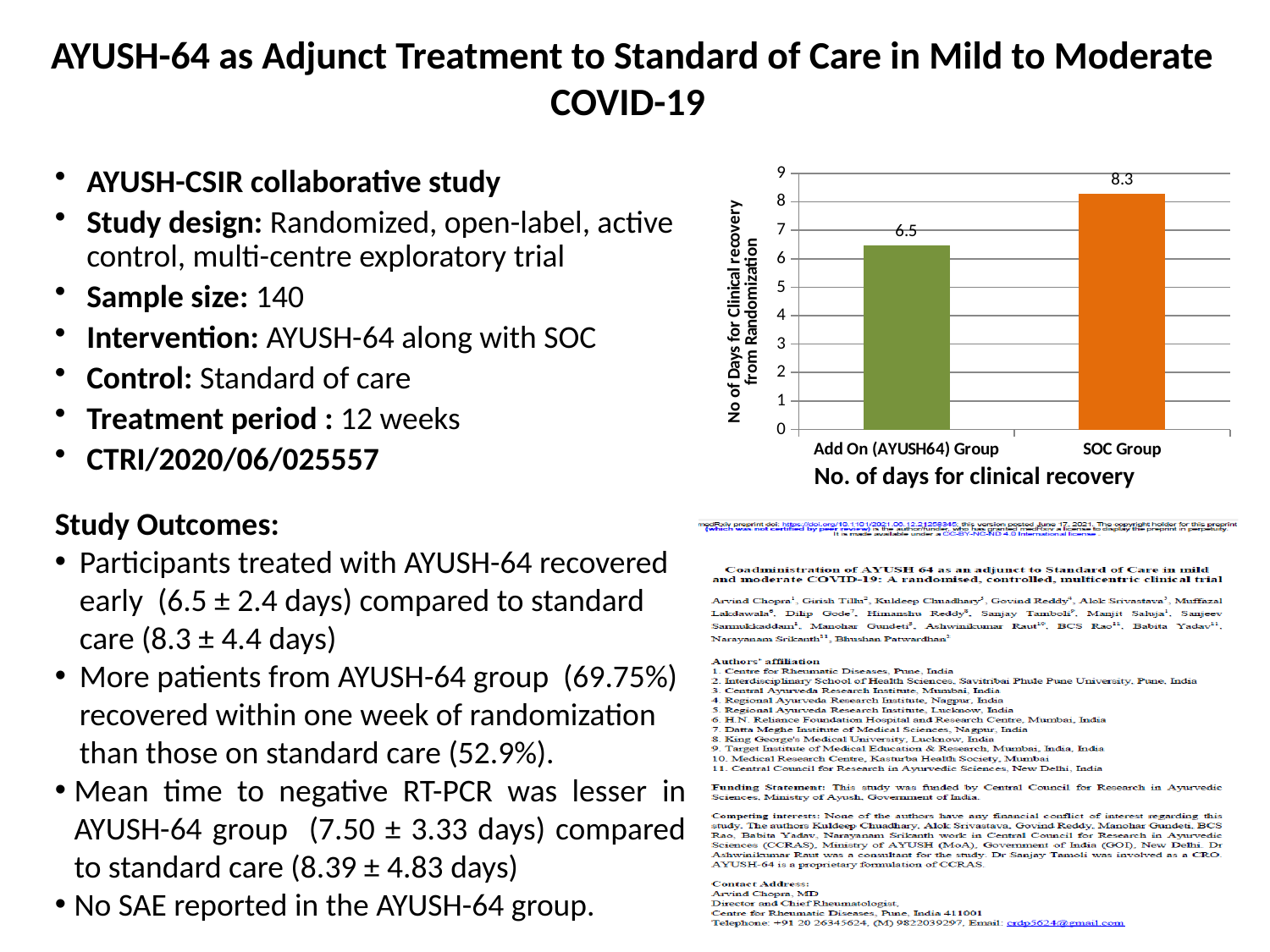
What type of chart is shown on the slide? bar chart What is the value for the SOC Group in the chart? 8.3 What is the title of the chart? No. of days for clinical recovery How many groups are shown in the chart? 2 What is the value for the Add On (AYUSH64) Group in the chart? 6.5 Is the value for the Add On (AYUSH64) Group larger or smaller than the value for the SOC Group? smaller Is the value for the SOC Group greater or less than 8? greater Is the value for the Add On (AYUSH64) Group greater or less than 7? less What is the label of the vertical axis of the chart? No of Days for Clinical recovery from Randomization Which group has the lower number of days for clinical recovery? Add On (AYUSH64) Group What is the difference in days for clinical recovery between the SOC Group and the Add On (AYUSH64) Group? 1.8 Which group has the higher number of days for clinical recovery? SOC Group